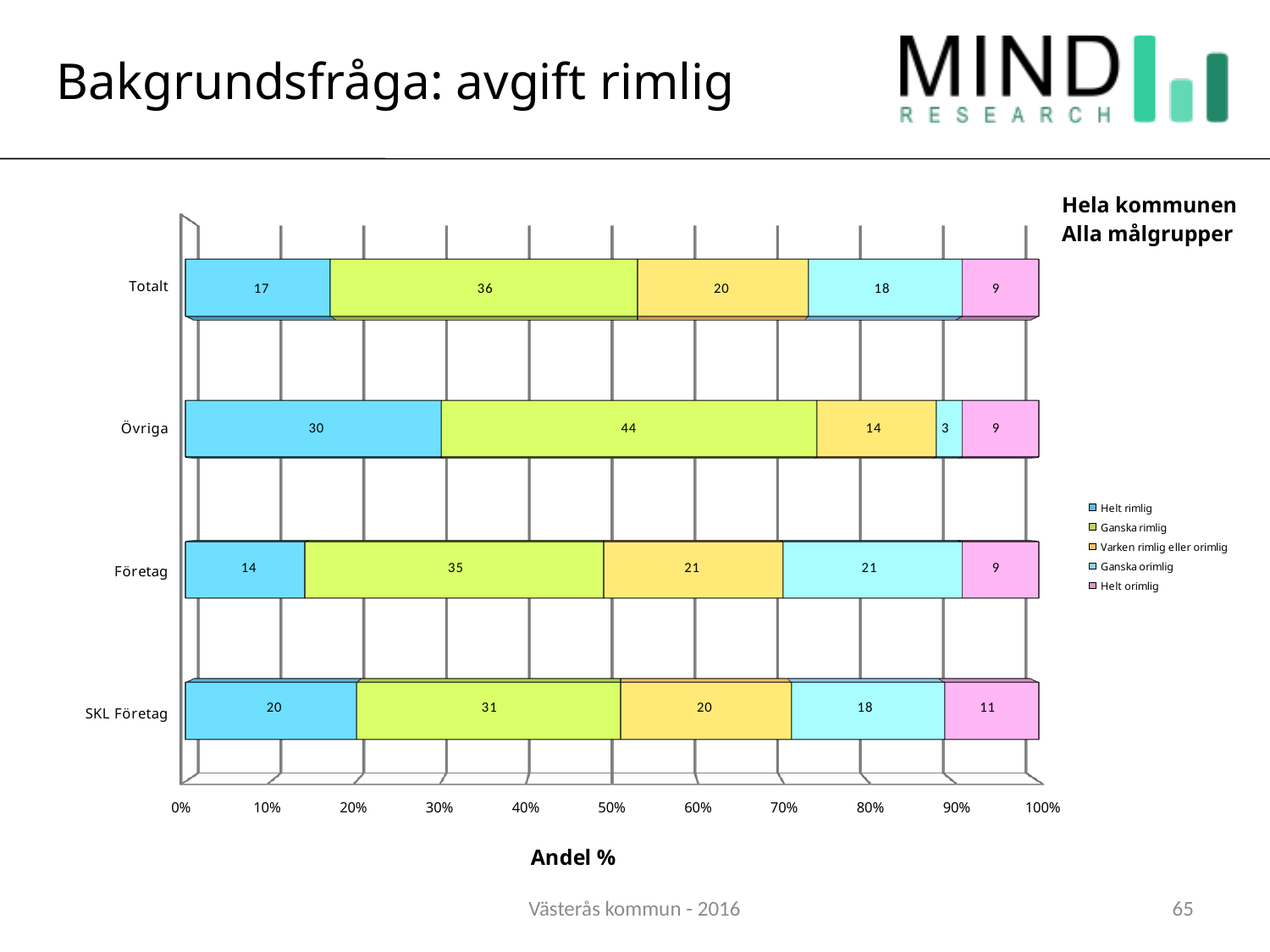
What is the value of "Ganska orimlig" for Företag? 21 What is the total of the stacked bar for SKL Företag? 100 Which category has the highest value for "Ganska rimlig"? Övriga How many categories are shown on the y axis? 4 What kind of chart is shown on the slide? Stacked bar chart What is the difference between the "Helt rimlig" values for Övriga and Företag? 16 Which category has the lowest value for "Ganska orimlig"? Övriga What is the value of "Helt orimlig" for Totalt? 9 What is the value of "Ganska rimlig" for SKL Företag? 31 Which is larger: the "Varken rimlig eller orimlig" value for Företag or for Övriga? Företag How many series does the legend list? 5 What is the value of "Helt rimlig" for Övriga? 30